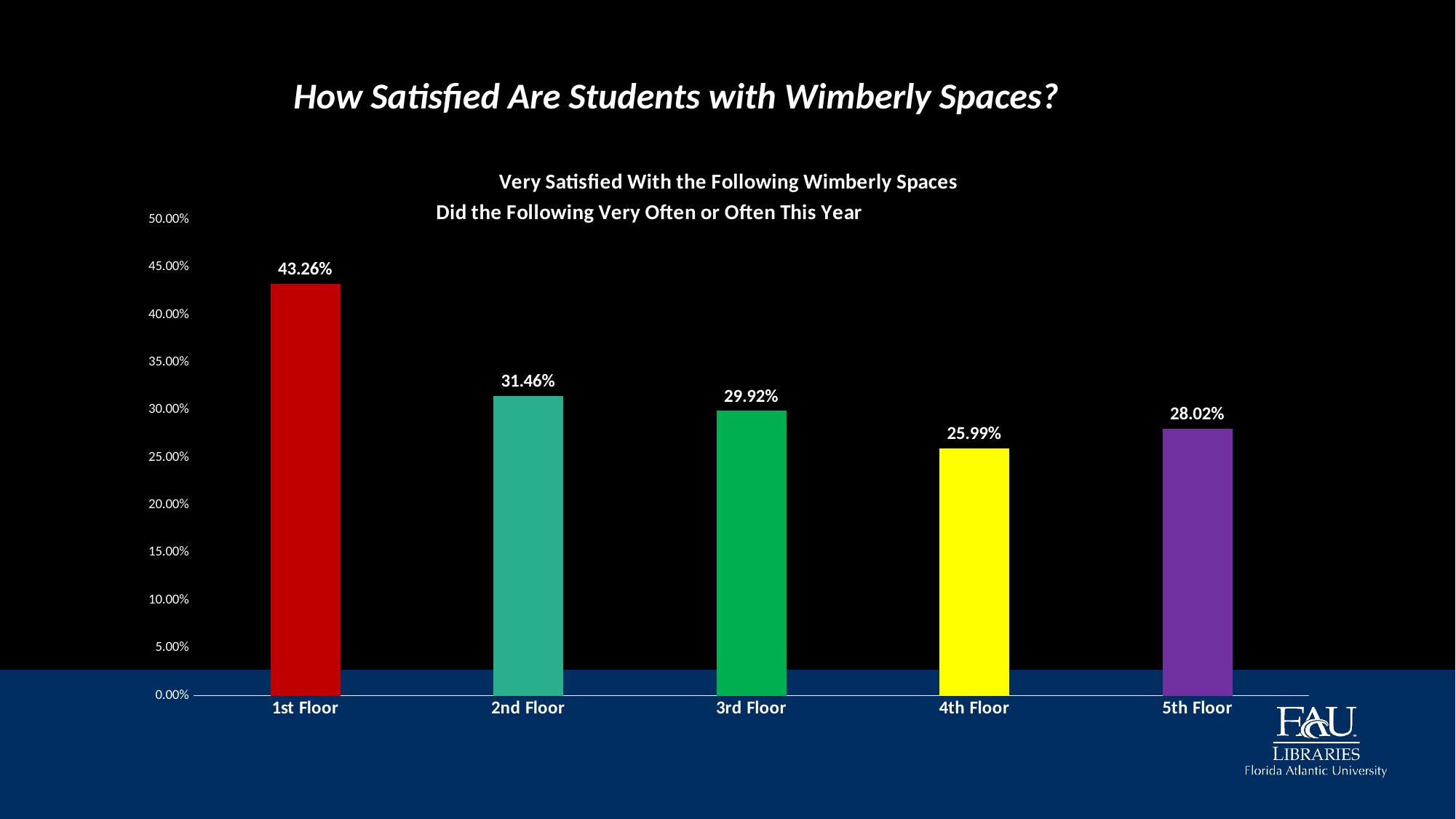
Which is larger, the value for 2nd Floor or the value for 3rd Floor? 2nd Floor What is the value for 4th Floor? 25.99% How many floors are shown on the chart? 5 Which floor has the lowest value? 4th Floor What is the difference between the values for 1st Floor and 2nd Floor? 11.80% What colour is the bar for 4th Floor? yellow What is the value for 1st Floor? 43.26% What kind of chart is shown on the slide? bar chart Is the value for 3rd Floor greater or less than 25.00%? greater What is the value for 5th Floor? 28.02% What is the difference between the values for 5th Floor and 4th Floor? 2.03% Which floor has the highest value? 1st Floor